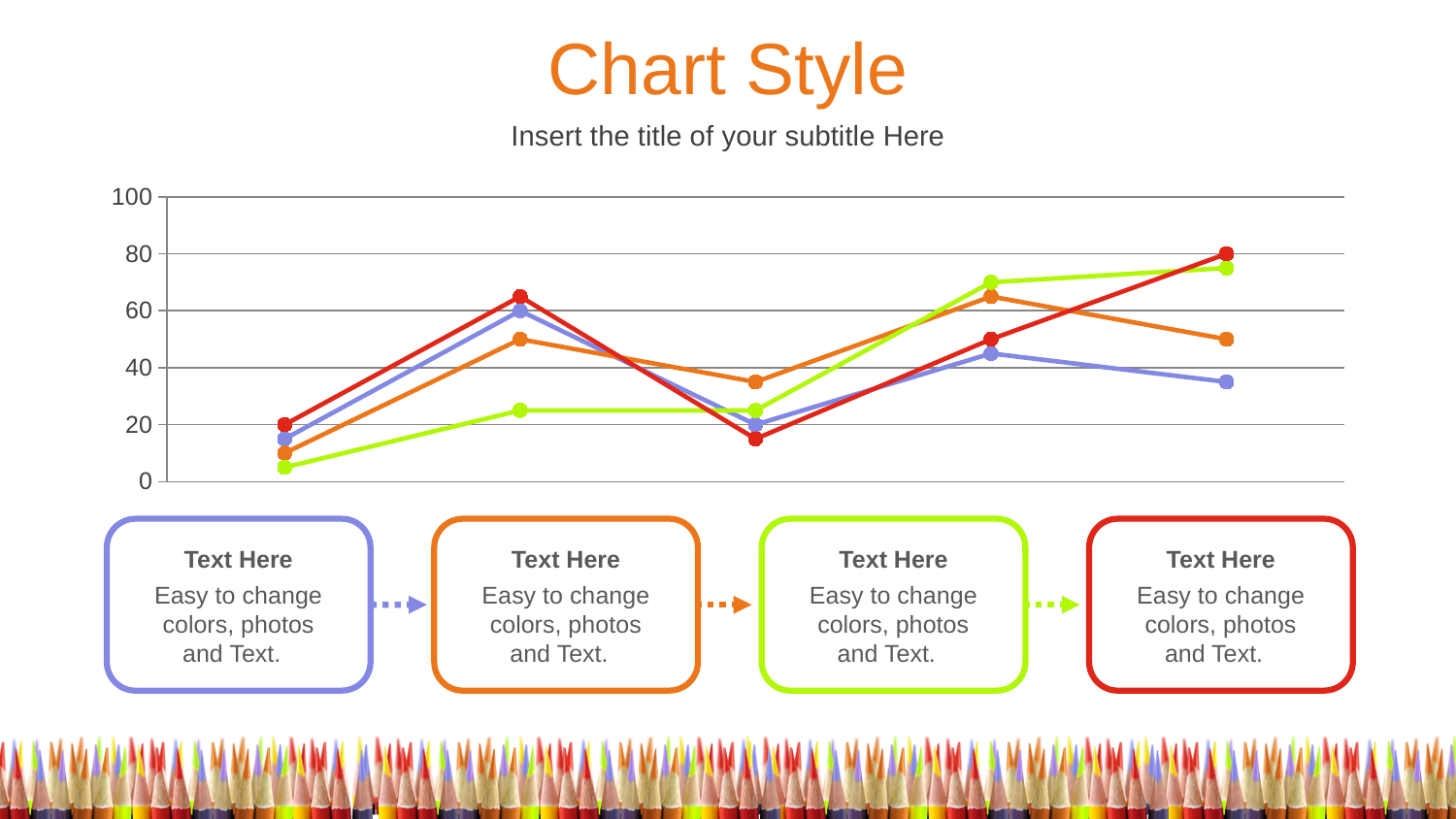
Is the value of the red line at its third point greater or less than 20? less How many data points does each line have? 5 At the last point, which is higher: the red line or the blue line? the red line What kind of chart is shown on the slide? line chart Is the value of the green line at its last point greater or less than 60? greater Which line reaches the highest value on the chart? the red line What is the value of the blue line at its second point? 60 Which line has the lowest value at the first point? the green line Does the green line rise or fall from its first point to its last point? rise How many lines are plotted on the chart? 4 Is the value of the orange line at its third point greater or less than 40? less What is the value of the red line at its last (fifth) point? 80